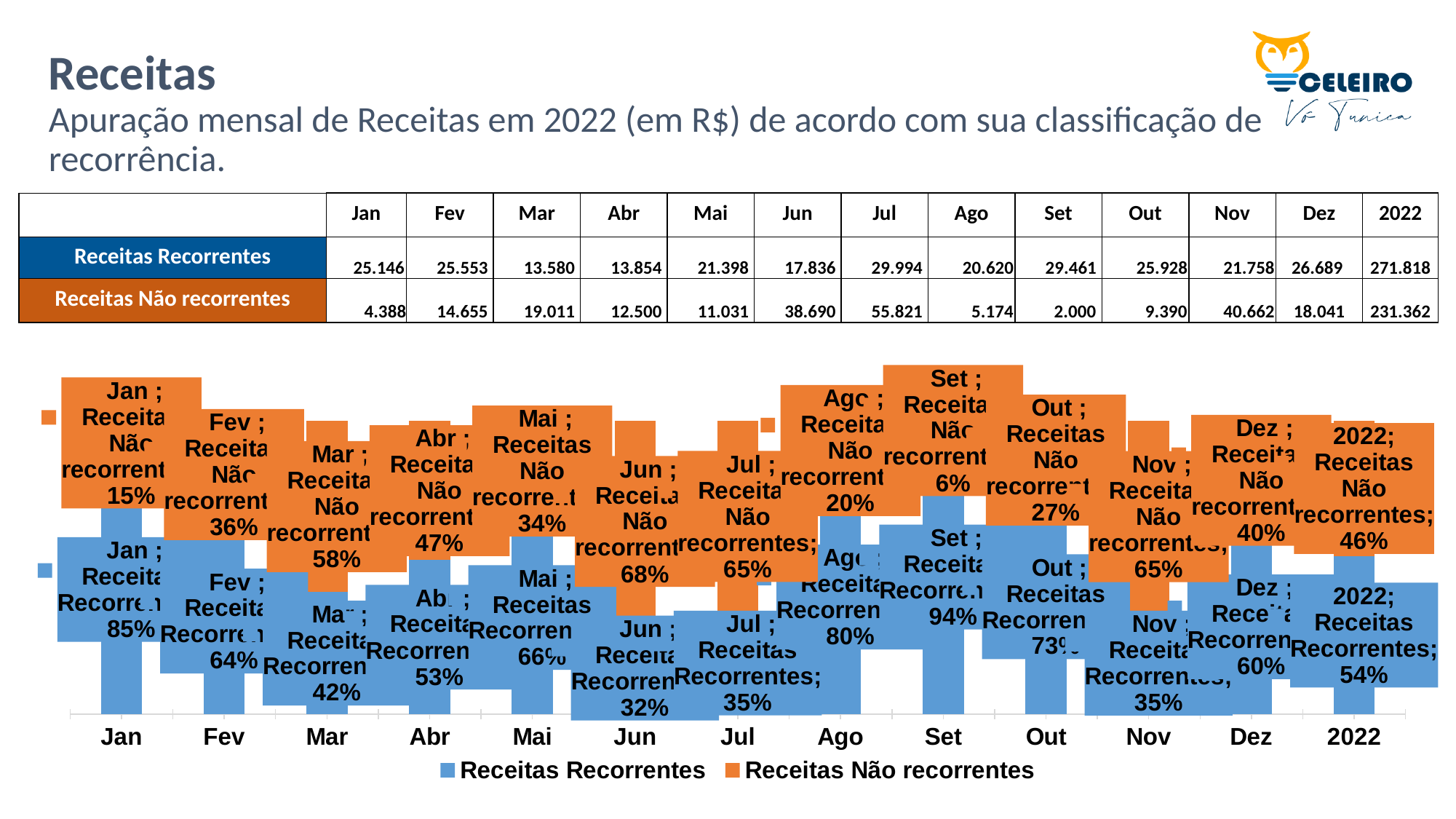
How many series does the chart legend list? 2 What is the Receitas Recorrentes share shown for Jan in the chart? 85% How many categories are shown along the x axis of the chart? 13 In which month does Receitas Recorrentes have its highest share in the chart? Set What kind of chart is shown on the slide? bar chart In which month does Receitas Recorrentes have its lowest share in the chart? Jun What is the Receitas Recorrentes share shown for 2022 in the chart? 54% In which month does Receitas Não recorrentes have its lowest share in the chart? Set Which is larger in the chart: the Receitas Recorrentes share for Ago or for Nov? Ago What is the Receitas Não recorrentes share shown for Jun in the chart? 68% Which colour represents Receitas Não recorrentes in the chart? orange What is the difference between the Receitas Recorrentes share in Jan (85%) and in Fev (64%)? 21%